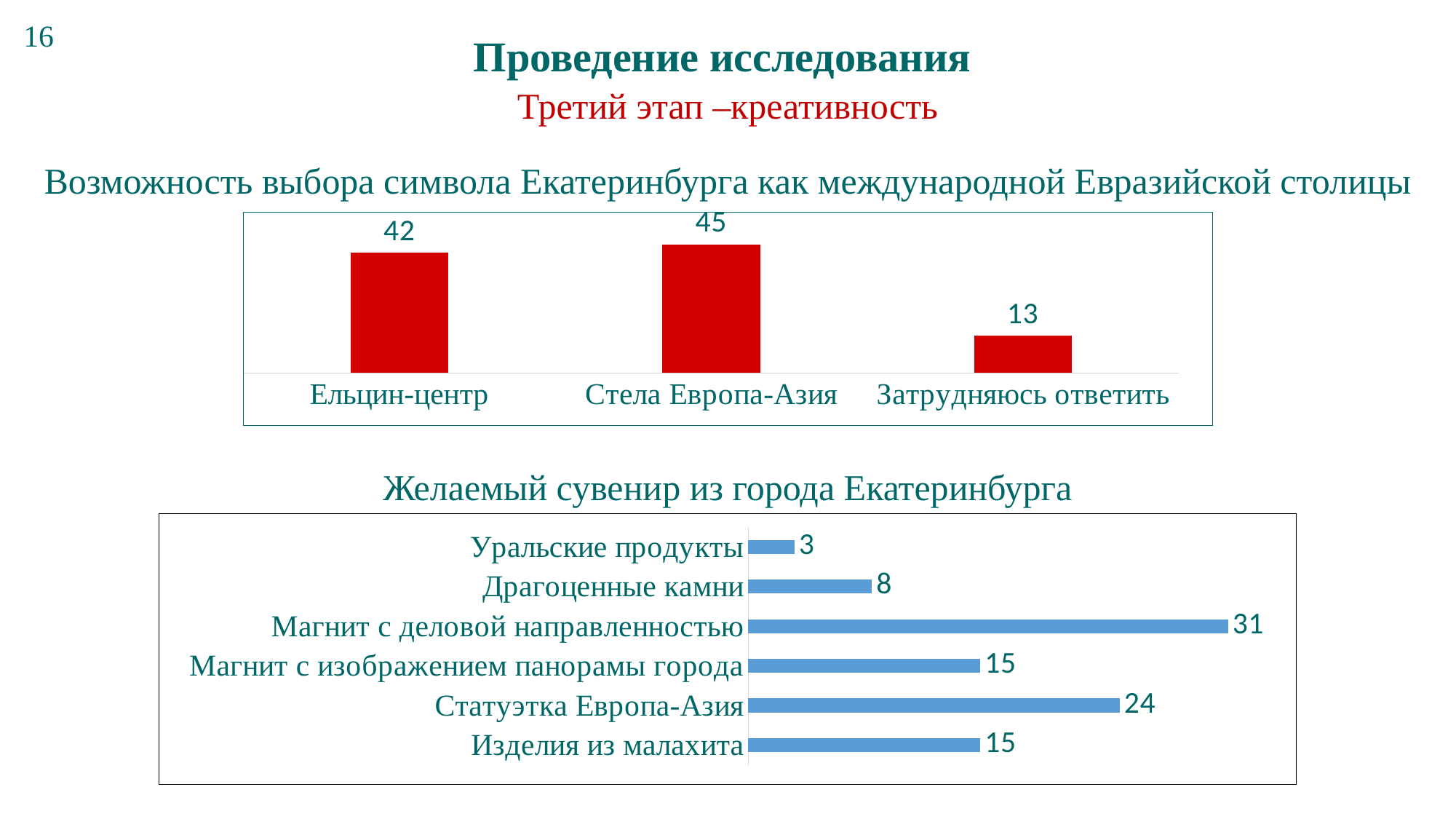
In the bottom chart (Желаемый сувенир из города Екатеринбурга), which is larger: Драгоценные камни or Изделия из малахита? Изделия из малахита In the bottom chart (Желаемый сувенир из города Екатеринбурга), what is the difference between Магнит с деловой направленностью and Магнит с изображением панорамы города? 16 What type of chart is the bottom chart (Желаемый сувенир из города Екатеринбурга)? Bar chart In the bottom chart (Желаемый сувенир из города Екатеринбурга), how many categories are shown? 6 In the bottom chart (Желаемый сувенир из города Екатеринбурга), what is the value for Статуэтка Европа-Азия? 24 In the top chart (Возможность выбора символа Екатеринбурга), what is the value for Ельцин-центр? 42 In the top chart (Возможность выбора символа Екатеринбурга), what is the difference between Стела Европа-Азия and Ельцин-центр? 3 In the bottom chart (Желаемый сувенир из города Екатеринбурга), which category has the highest value? Магнит с деловой направленностью In the top chart (Возможность выбора символа Екатеринбурга), which category has the lowest value? Затрудняюсь ответить In the top chart (Возможность выбора символа Екатеринбурга), how many categories are shown? 3 In the bottom chart (Желаемый сувенир из города Екатеринбурга), which category has the lowest value? Уральские продукты In the top chart (Возможность выбора символа Екатеринбурга), which category has the highest value? Стела Европа-Азия